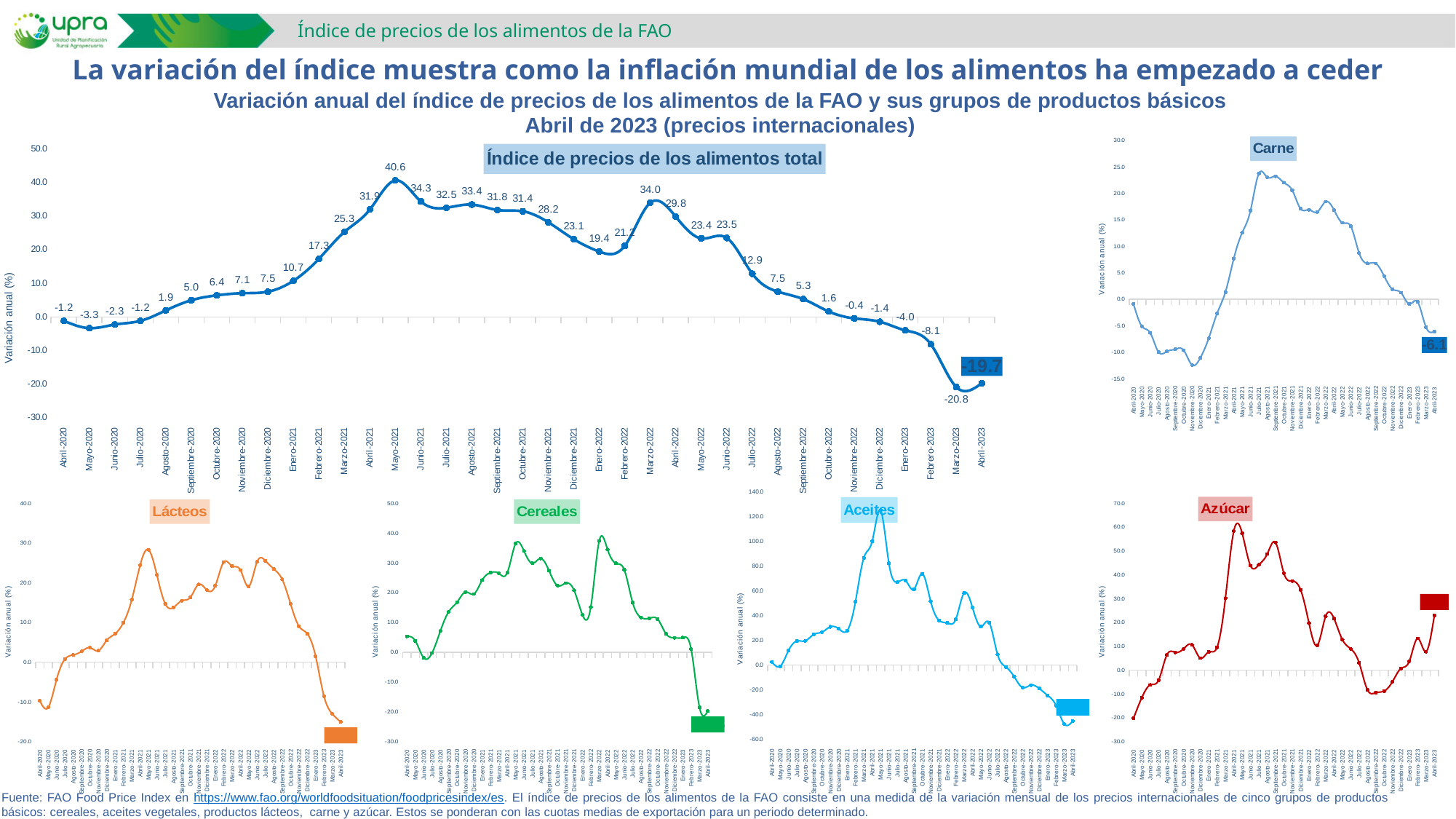
On the 'Índice de precios de los alimentos total' chart, what is the value for Mayo-2021? 40.6 On the 'Índice de precios de los alimentos total' chart, what is the value for Marzo-2022? 34.0 On the 'Índice de precios de los alimentos total' chart, which month has the highest value? Mayo-2021 What kind of chart is the 'Azúcar' chart? Line chart On the 'Aceites' chart, is the peak value greater or less than 100.0? greater How many data points are plotted on the 'Índice de precios de los alimentos total' chart? 37 On the 'Carne' chart, is the peak value greater or less than 20.0? greater On the 'Índice de precios de los alimentos total' chart, do the values rise or fall from Julio-2022 to Marzo-2023? Fall On the 'Índice de precios de los alimentos total' chart, what is the difference between the values for Mayo-2021 and Junio-2021? 6.3 On the 'Índice de precios de los alimentos total' chart, what is the value for Abril-2023? -19.7 On the 'Índice de precios de los alimentos total' chart, which is larger, the value for Abril-2022 or the value for Mayo-2022? Abril-2022 On the 'Índice de precios de los alimentos total' chart, which month has the lowest value? Marzo-2023